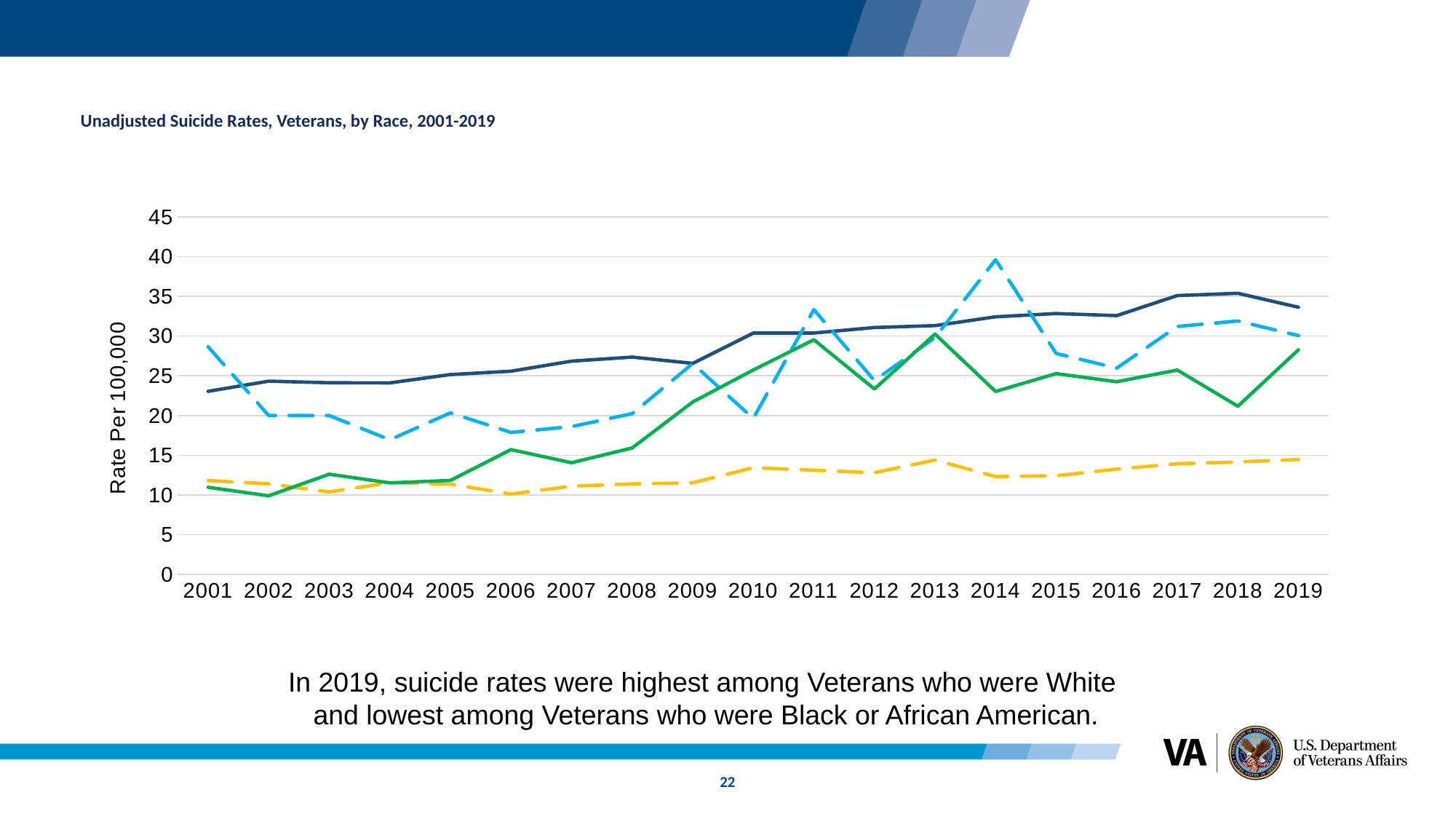
Is the value of the light blue dashed line in 2014 greater or less than 35? greater How many years are shown along the x axis of the chart? 19 What is the label on the vertical axis of the chart? Rate Per 100,000 Is the value of the yellow dashed line in 2019 greater or less than 20? less How many lines are plotted on the chart? 4 What is the title of the chart? Unadjusted Suicide Rates, Veterans, by Race, 2001-2019 What kind of chart is shown on the slide? line chart Is the value of the dark navy solid line in 2019 greater or less than 30? greater Which line has the highest value in 2014? the light blue dashed line Does the dark navy solid line generally rise or fall from 2001 to 2019? rise Which line has the lowest value in 2019? the yellow dashed line